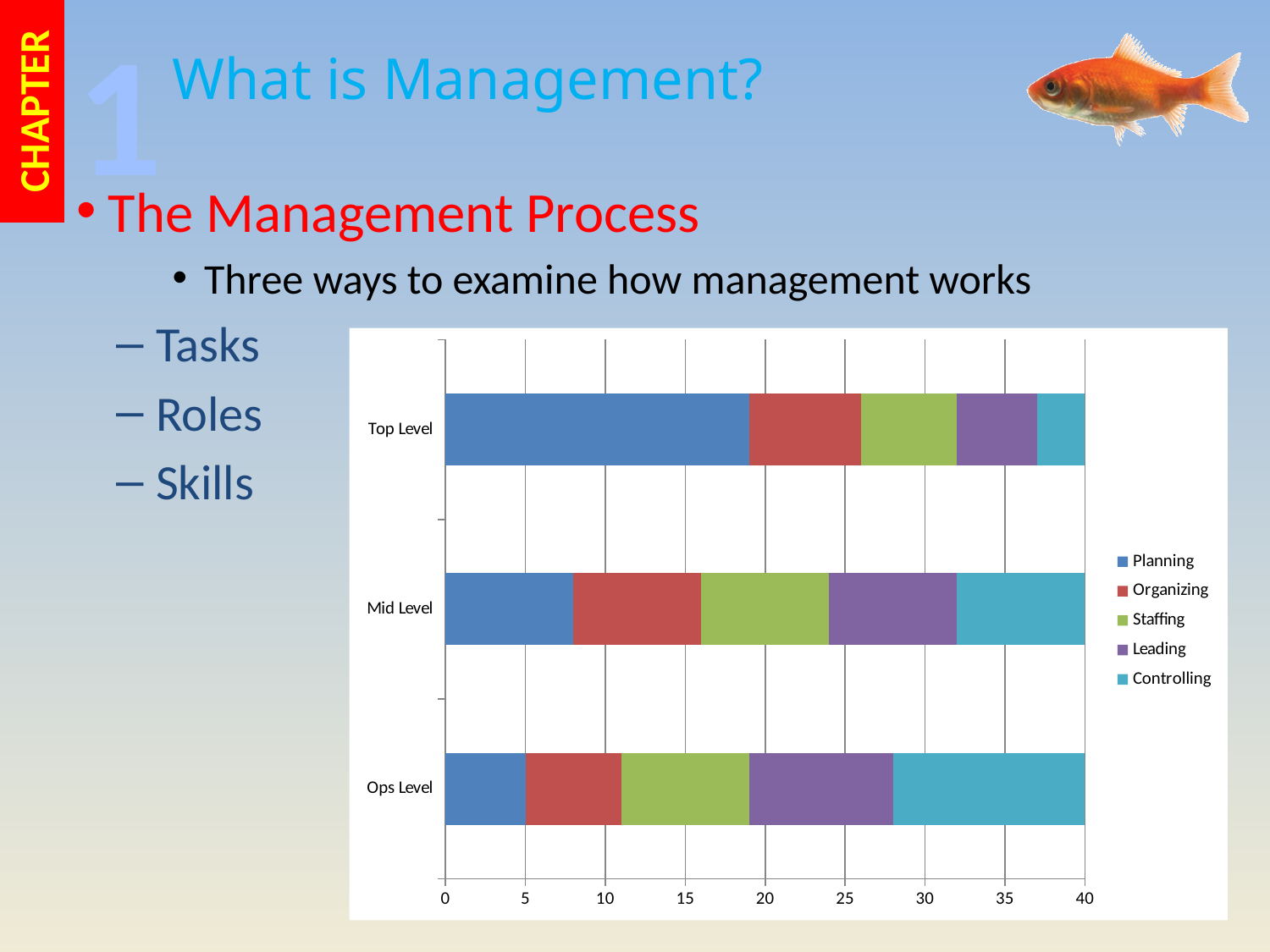
What kind of chart is shown on the slide? Stacked bar chart Which series is listed first in the chart legend? Planning Which management level has the largest Planning segment? Top Level Is the Planning value for Top Level greater or less than 15? greater Which management level has the largest Controlling segment? Ops Level Is the Controlling value for Ops Level greater or less than 10? greater Which management level has the smallest Planning segment? Ops Level Is the Planning value for Mid Level greater or less than 10? less Is the Planning segment larger for Top Level or for Ops Level? Top Level Is the Controlling segment larger for Ops Level or for Top Level? Ops Level How many series does the chart legend list? 5 How many management levels (categories) are shown on the chart? 3